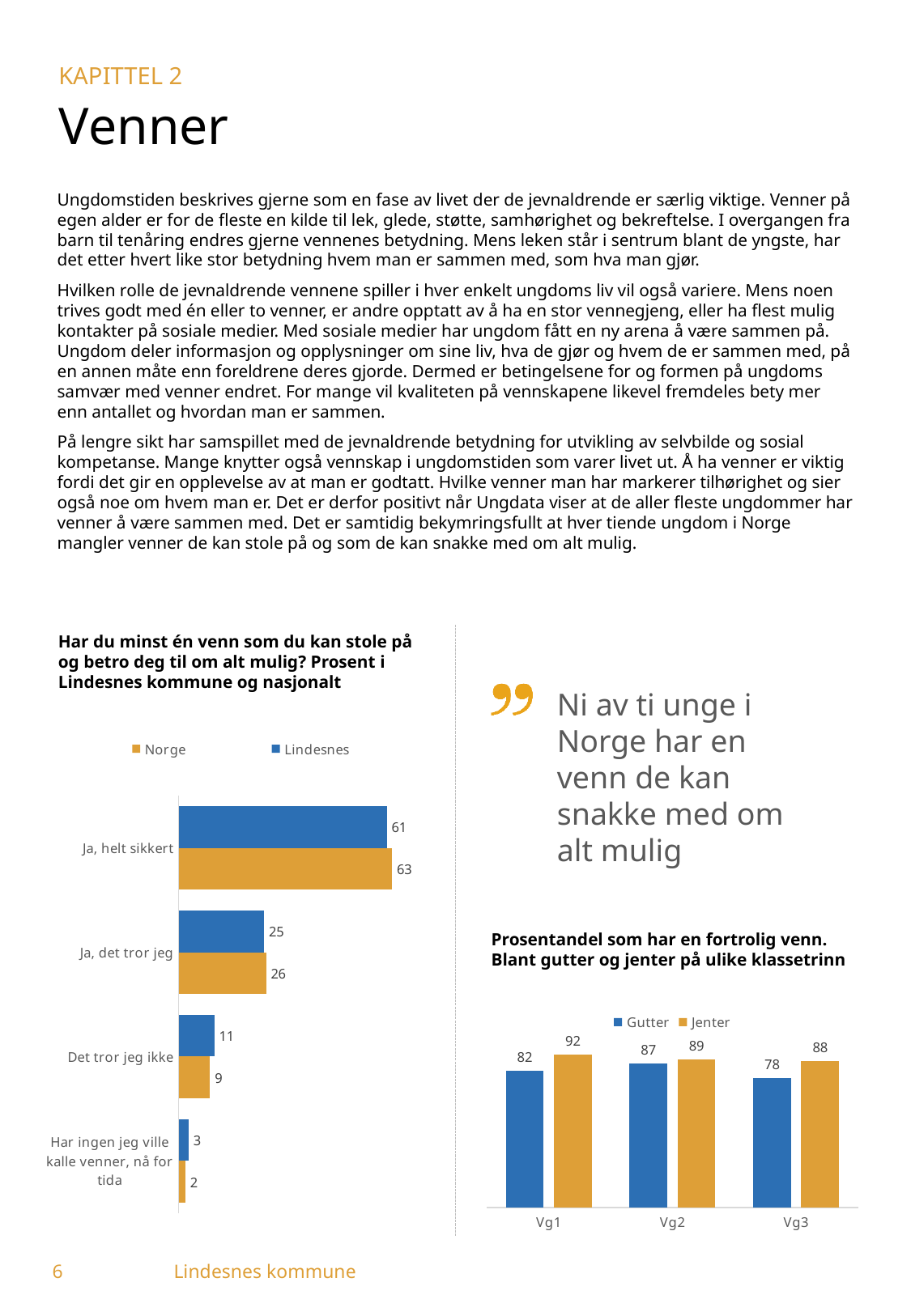
In the left chart (Har du minst én venn som du kan stole på...), which category has the highest value for Lindesnes? Ja, helt sikkert In the left chart (Har du minst én venn som du kan stole på...), what is the difference between Lindesnes and Norge for 'Det tror jeg ikke'? 2 In the right chart (Prosentandel som har en fortrolig venn), which class level has the lowest value for Gutter? Vg3 What kind of chart is the right chart (Prosentandel som har en fortrolig venn)? Bar chart In the left chart (Har du minst én venn som du kan stole på...), how many categories are shown? 4 In the left chart (Har du minst én venn som du kan stole på...), what is the value for Lindesnes for 'Ja, helt sikkert'? 61 In the right chart (Prosentandel som har en fortrolig venn), what is the value for Gutter at Vg3? 78 In the right chart (Prosentandel som har en fortrolig venn), what is the difference between Jenter and Gutter at Vg1? 10 In the left chart (Har du minst én venn som du kan stole på...), what is the value for Norge for 'Ja, det tror jeg'? 26 In the right chart (Prosentandel som har en fortrolig venn), what is the value for Jenter at Vg1? 92 In the left chart (Har du minst én venn som du kan stole på...), how many series does the legend list? 2 In the left chart (Har du minst én venn som du kan stole på...), what is the value for Norge for 'Har ingen jeg ville kalle venner, nå for tida'? 2